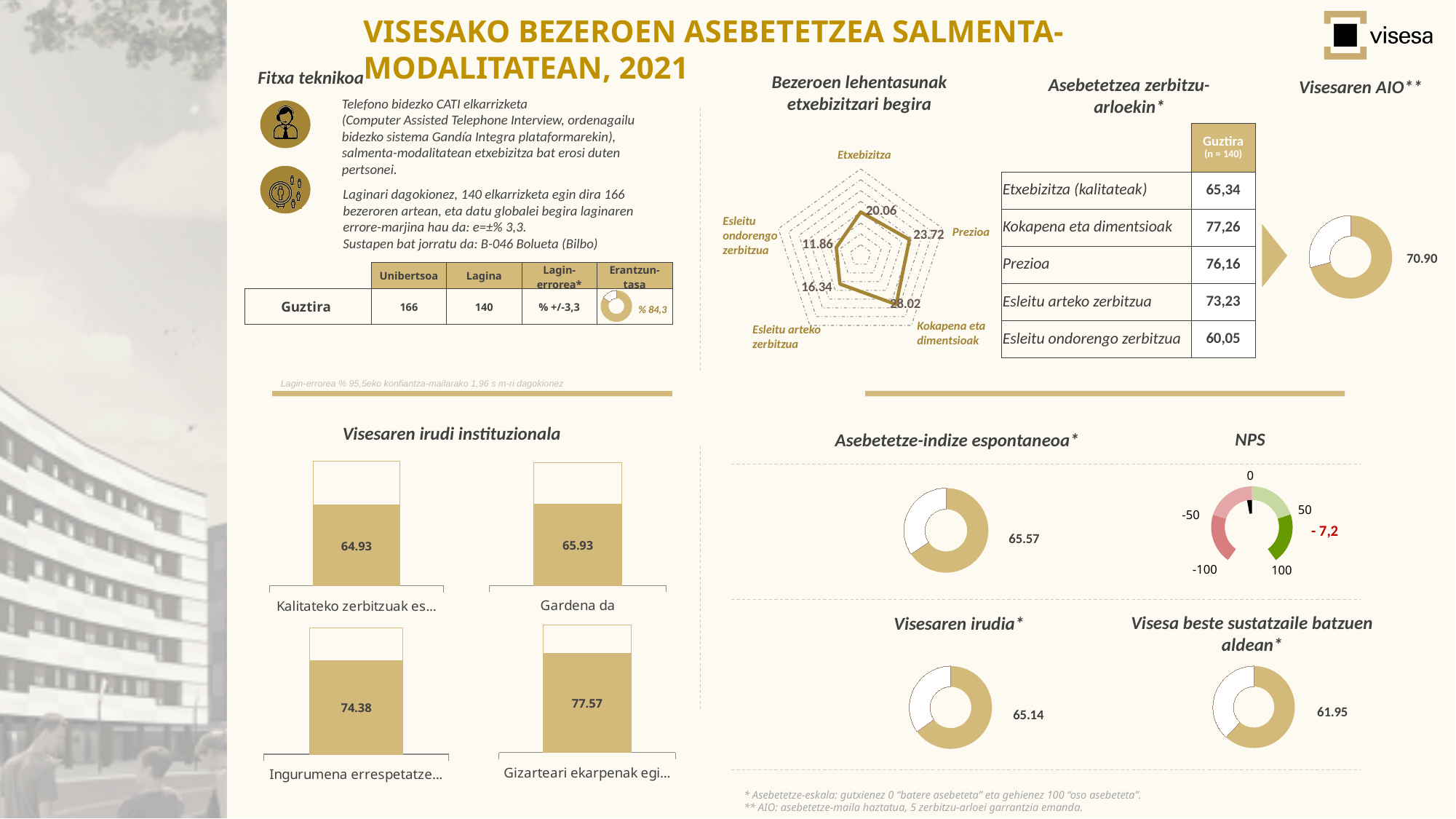
In the radar chart 'Bezeroen lehentasunak etxebizitzari begira', what is the value for Etxebizitza? 20.06 In the radar chart 'Bezeroen lehentasunak etxebizitzari begira', what is the difference between the values for Prezioa and Esleitu arteko zerbitzua? 7.38 In the 'Visesaren irudi instituzionala' charts, what is the value for 'Gardena da'? 65.93 In the 'Visesaren irudi instituzionala' charts, which item has the highest value? Gizarteari ekarpenak egi… In the radar chart 'Bezeroen lehentasunak etxebizitzari begira', which category has the lowest value? Esleitu ondorengo zerbitzua Which is larger: the value in the 'Visesaren irudia' donut chart or the value in the 'Visesa beste sustatzaile batzuen aldean' donut chart? Visesaren irudia What value does the NPS gauge show? - 7,2 What value is shown in the 'Visesaren AIO' donut chart? 70.90 In the radar chart 'Bezeroen lehentasunak etxebizitzari begira', how many categories are plotted? 5 In the 'Visesaren irudi instituzionala' charts, what is the difference between 'Ingurumena errespetatze…' and 'Kalitateko zerbitzuak es…'? 9.45 In the radar chart 'Bezeroen lehentasunak etxebizitzari begira', what is the value for Kokapena eta dimentsioak? 28.02 In the radar chart 'Bezeroen lehentasunak etxebizitzari begira', which category has the highest value? Kokapena eta dimentsioak